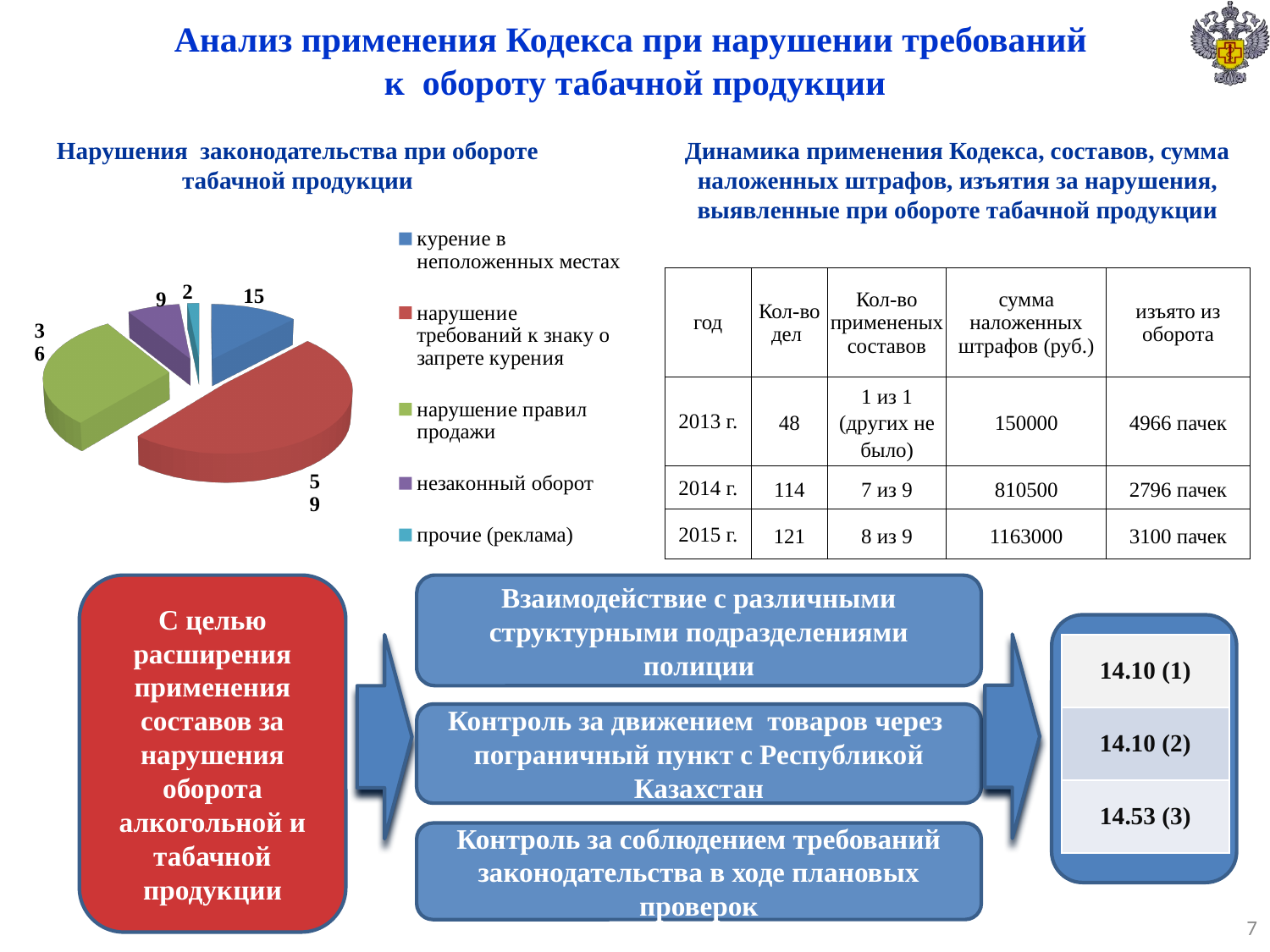
In the pie chart, what is the value for 'нарушение требований к знаку о запрете курения'? 59 In the pie chart, which is larger: 'курение в неположенных местах' or 'незаконный оборот'? курение в неположенных местах How many categories does the pie chart's legend list? 5 In the pie chart, what is the value for 'курение в неположенных местах'? 15 In the pie chart, what is the value for 'незаконный оборот'? 9 What colour is the slice for 'нарушение правил продажи' in the pie chart? green Which category has the largest slice in the pie chart? нарушение требований к знаку о запрете курения Which category has the smallest slice in the pie chart? прочие (реклама) What type of chart is shown on the left of the slide under the heading 'Нарушения законодательства при обороте табачной продукции'? pie chart In the pie chart, what is the value for 'прочие (реклама)'? 2 In the pie chart, what is the difference between the values for 'нарушение требований к знаку о запрете курения' and 'нарушение правил продажи'? 23 In the pie chart, what is the value for 'нарушение правил продажи'? 36